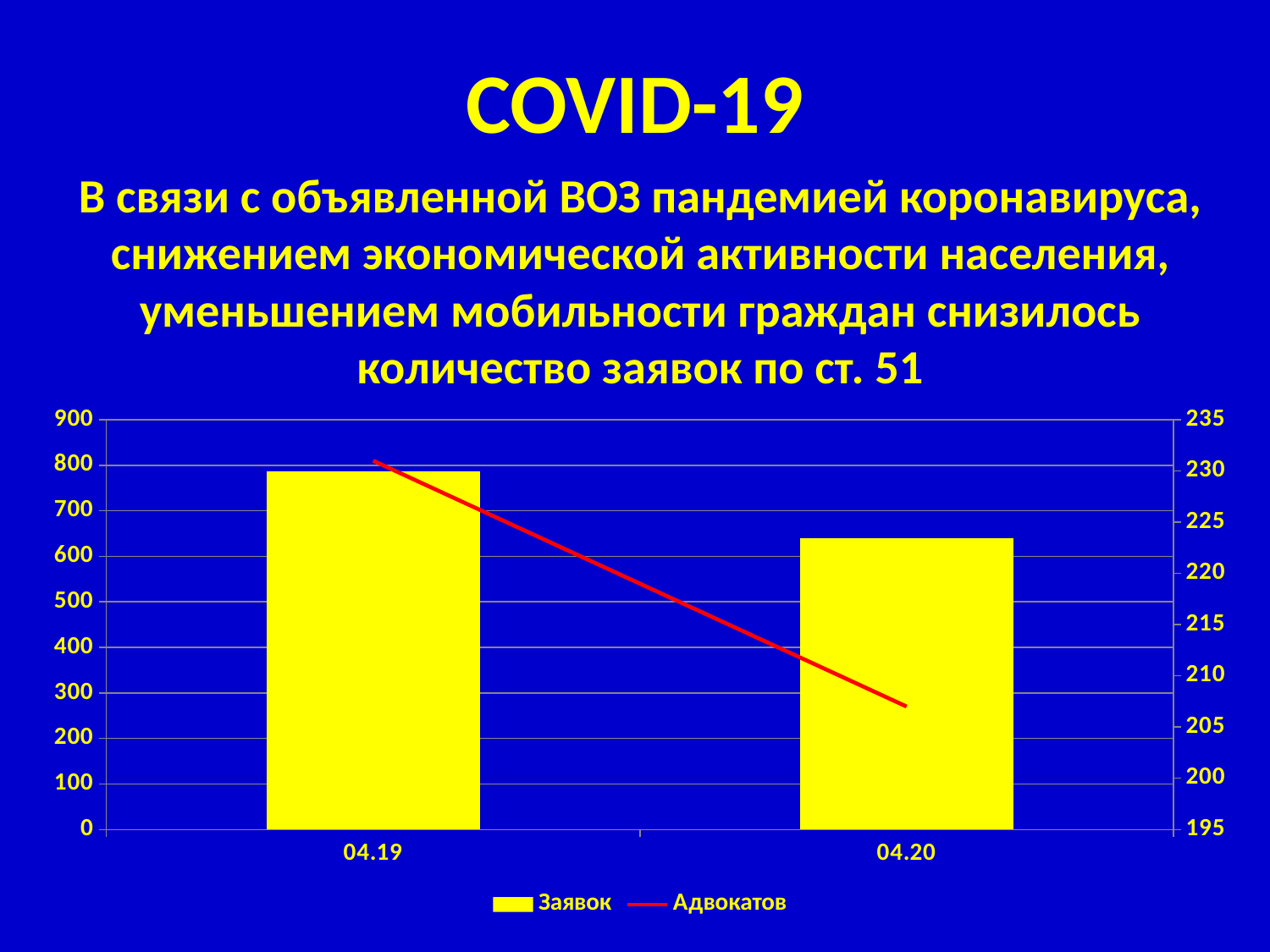
What colour are the bars for Заявок? yellow How many categories are shown on the x axis? 2 Is the value for Заявок in 04.20 greater or less than 700? less Which category has the lowest value for Заявок? 04.20 Is the value for Заявок in 04.19 greater or less than 700? greater Is the value for Адвокатов in 04.19 greater or less than 225 on the right axis? greater How many series does the legend list? 2 What kind of chart is shown on the slide? bar chart with a line Do the values for Адвокатов rise or fall from 04.19 to 04.20? fall Which category has the higher value for Заявок, 04.19 or 04.20? 04.19